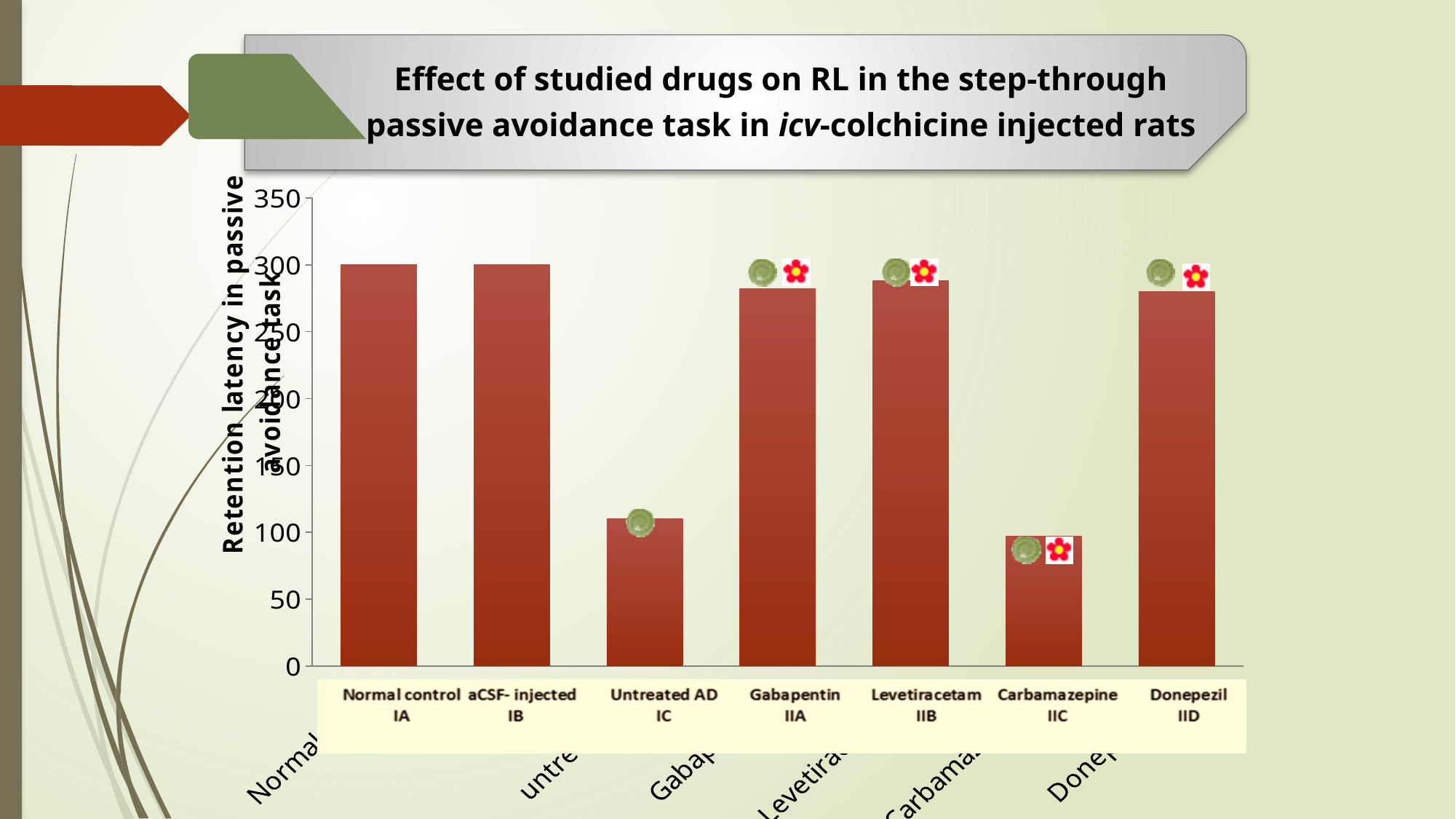
How many categories (groups) are plotted in the chart? 7 Which group has the lowest retention latency? Carbamazepine IIC What type of chart is shown on the slide? Bar chart Which has a higher retention latency, Untreated AD IC or Carbamazepine IIC? Untreated AD IC What is the label of the vertical axis? Retention latency in passive avoidance task Which has a higher retention latency, Normal control IA or Untreated AD IC? Normal control IA Is the value for Untreated AD IC greater or less than 100? greater What is the retention latency value for the aCSF-injected IB group? 300 Is the value for Donepezil IID greater or less than 300? less Is the value for Gabapentin IIA greater or less than 250? greater What is the retention latency value for the Normal control IA group? 300